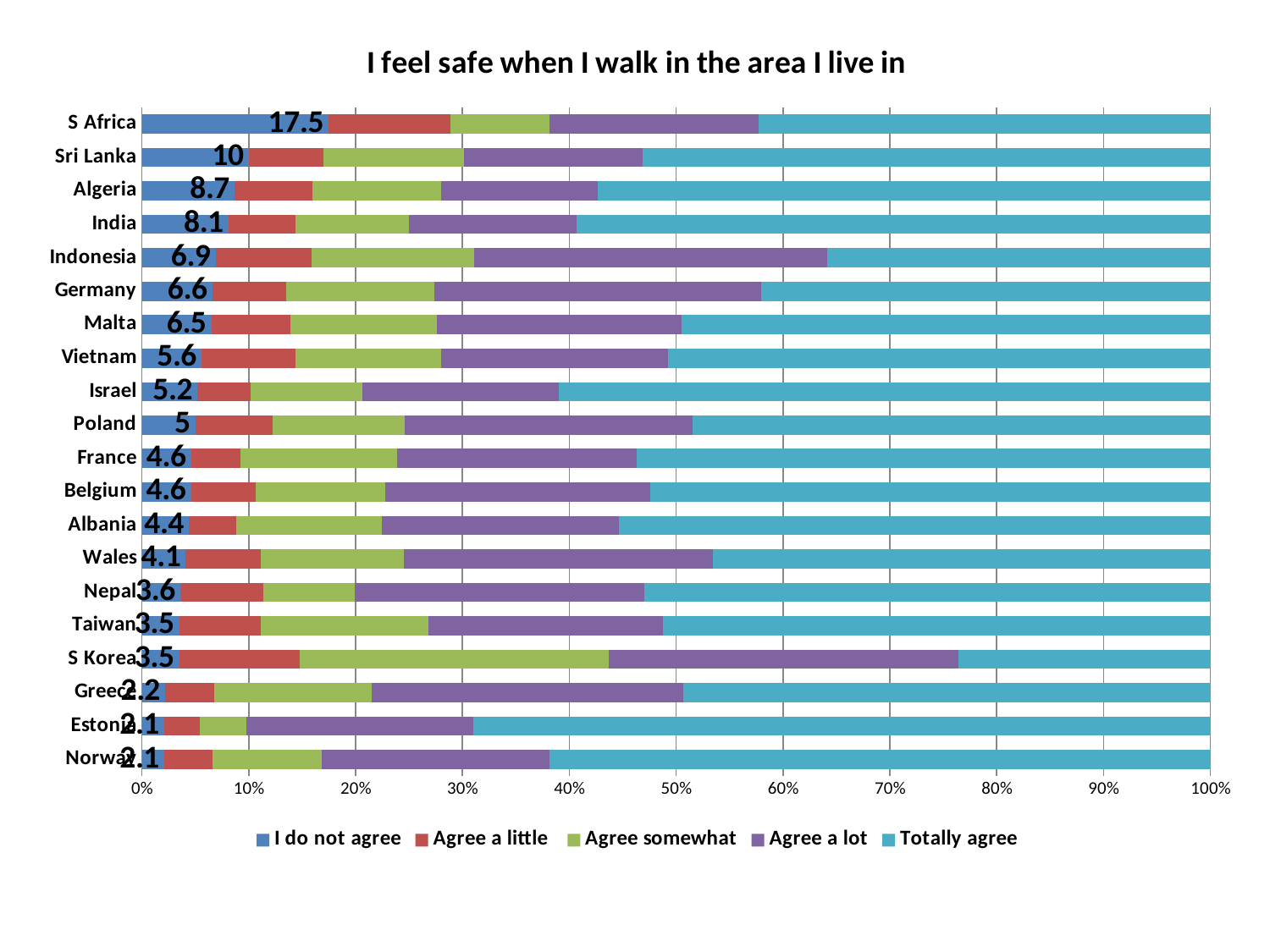
What is the value for 'I do not agree' for Germany? 6.6 Which country has the highest 'I do not agree' value? S Africa What is the value for 'I do not agree' for S Africa? 17.5 Is the 'Totally agree' share for S Korea greater or less than 30%? less How many countries are shown in the chart? 20 What is the title of the chart? I feel safe when I walk in the area I live in Is the 'Totally agree' share for Estonia greater or less than 60%? greater What is the value for 'I do not agree' for Sri Lanka? 10 What is the difference between the 'I do not agree' values for S Africa and Sri Lanka? 7.5 Which has a larger 'I do not agree' value, Algeria or India? Algeria How many series does the legend list? 5 What kind of chart is shown on the slide? Stacked bar chart